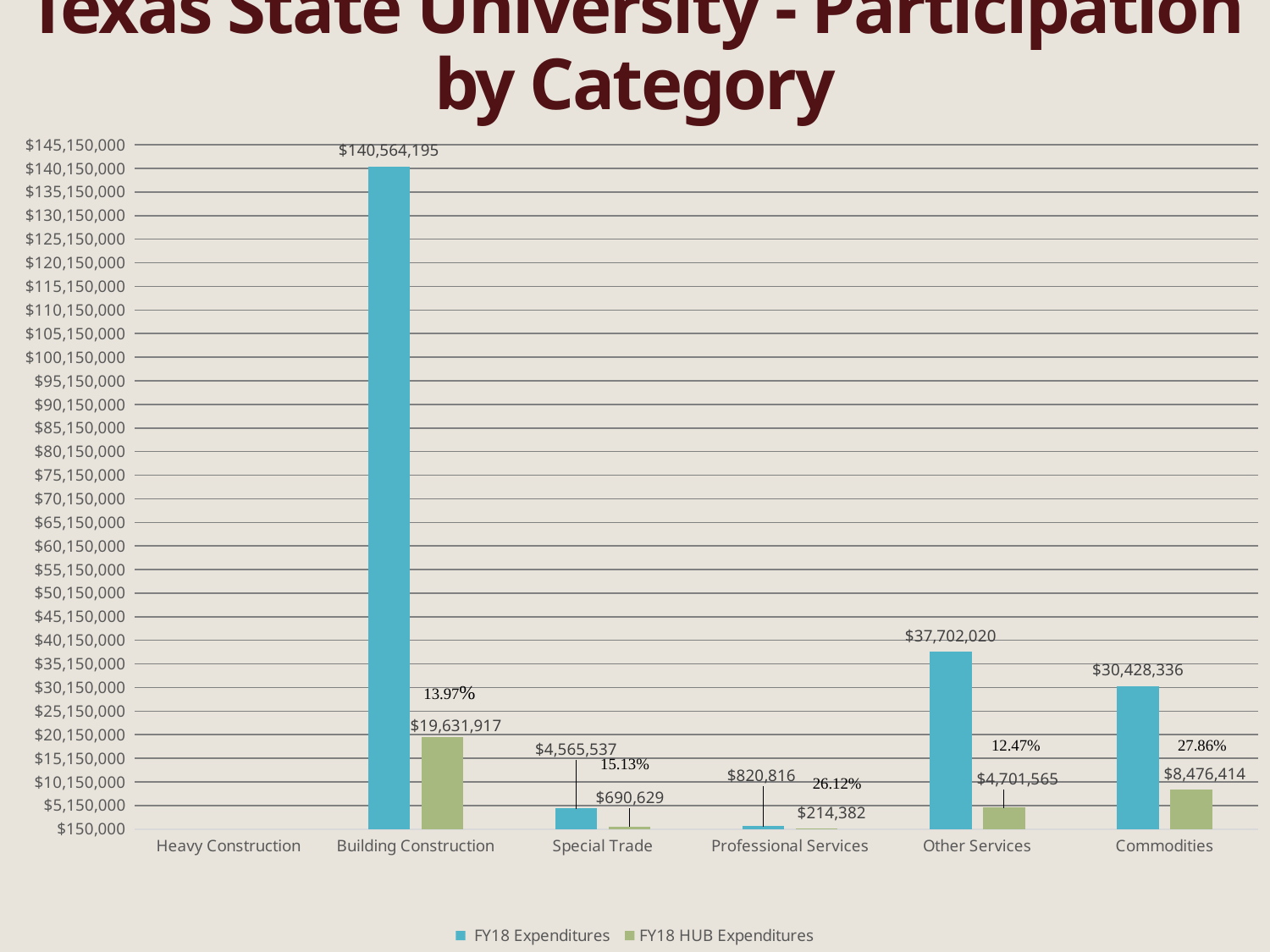
Which category has the highest FY18 HUB Expenditures? Building Construction What is the difference between the FY18 HUB Expenditures for Commodities and Other Services? $3,774,849 What is the FY18 HUB Expenditures value for Commodities? $8,476,414 What is the FY18 Expenditures value for Building Construction? $140,564,195 How many series does the legend list? 2 What is the FY18 HUB Expenditures value for Professional Services? $214,382 Is the FY18 Expenditures value for Commodities greater or less than $35,150,000? less Which category has the highest FY18 Expenditures? Building Construction What type of chart is shown on the slide? Bar chart What is the FY18 Expenditures value for Other Services? $37,702,020 What is the difference between the FY18 Expenditures for Other Services and Commodities? $7,273,684 Which is larger: FY18 HUB Expenditures for Special Trade or for Professional Services? Special Trade